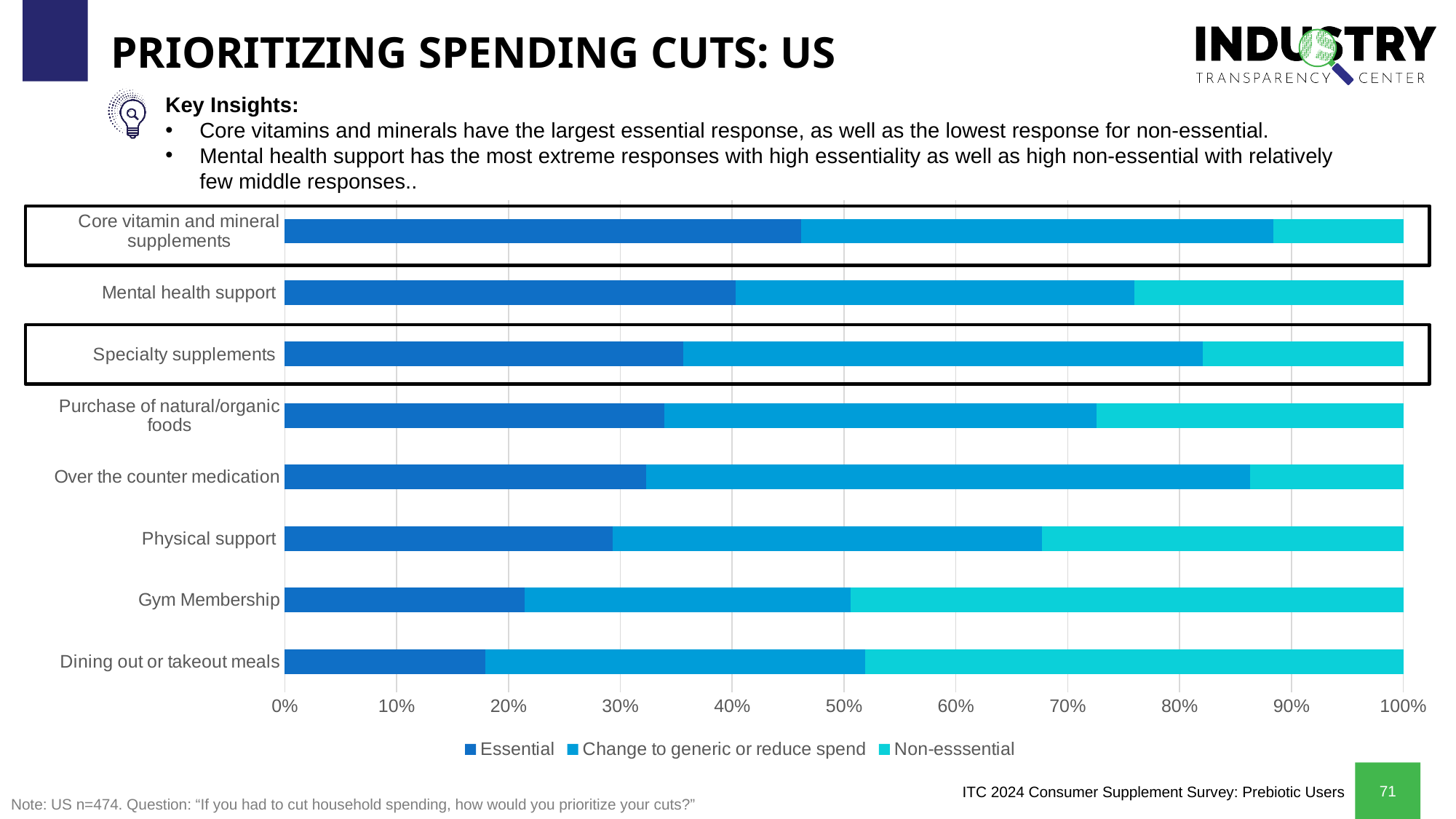
Which has a larger Essential segment: Mental health support or Physical support? Mental health support Is the Essential value for Dining out or takeout meals greater or less than 20%? less Is the Essential value for Core vitamin and mineral supplements greater or less than 40%? greater Which category has the largest Essential segment? Core vitamin and mineral supplements How many series does the chart legend list? 3 Is the Essential value for Mental health support greater or less than 30%? greater Which category has the smallest Essential segment? Dining out or takeout meals What kind of chart is shown on the slide? Stacked bar chart Which has a larger Essential segment: Core vitamin and mineral supplements or Gym Membership? Core vitamin and mineral supplements What are the three series named in the chart legend? Essential, Change to generic or reduce spend, Non-esssential How many spending categories are plotted on the chart? 8